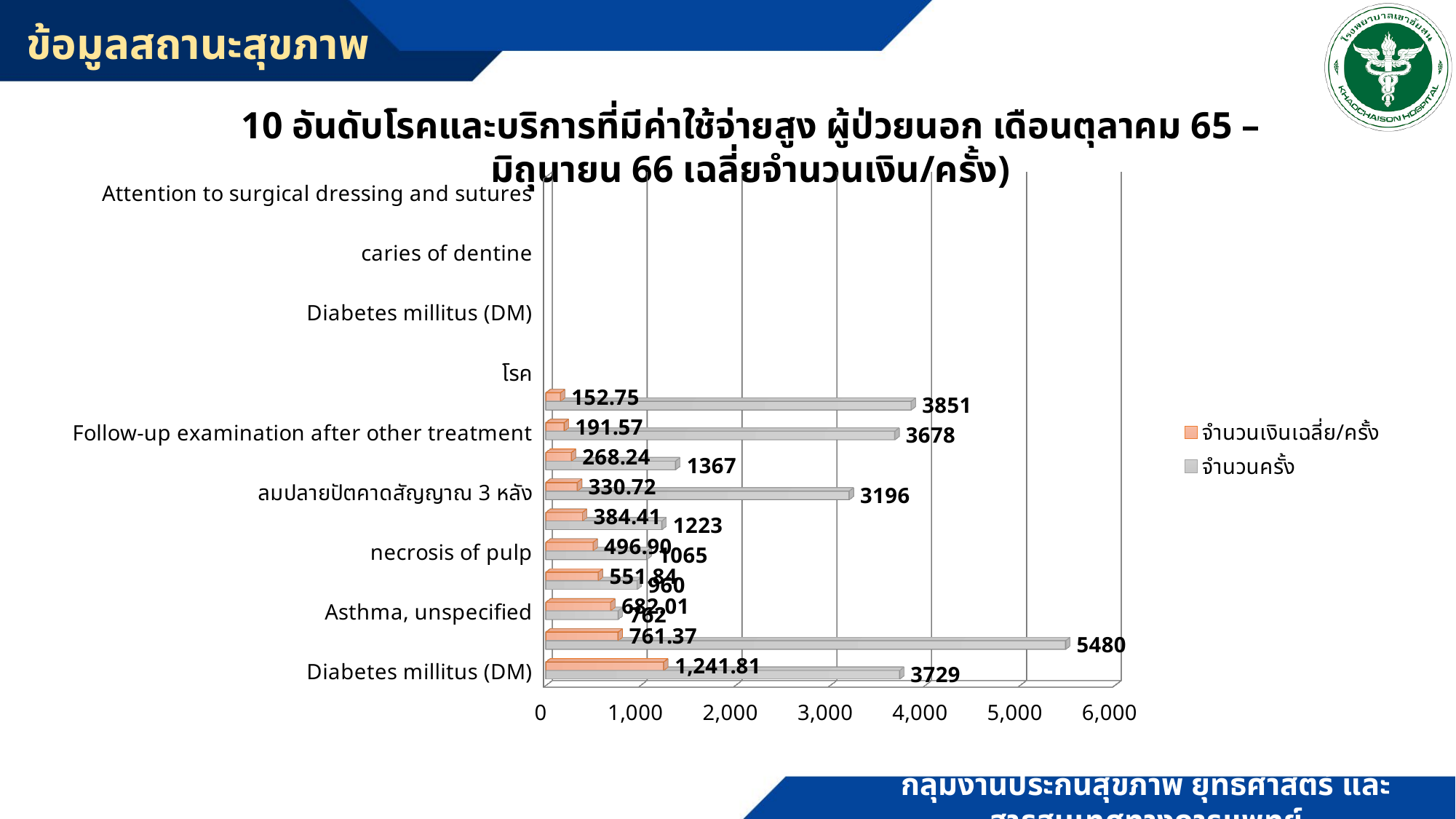
What is the highest จำนวนเงินเฉลี่ย/ครั้ง value shown in the chart? 1,241.81 Is the highest จำนวนครั้ง value greater or less than 5,000? greater What is the difference between the highest จำนวนครั้ง value (5480) and the จำนวนครั้ง value of the bottom bar (3729)? 1751 What is the lowest จำนวนเงินเฉลี่ย/ครั้ง value shown in the chart? 152.75 What type of chart is shown on the slide? bar chart What is the lowest จำนวนครั้ง value shown in the chart? 762 What is the จำนวนเงินเฉลี่ย/ครั้ง value for Asthma, unspecified? 682.01 How many series does the legend list? 2 What is the highest จำนวนครั้ง value shown in the chart? 5480 Which colour represents the จำนวนครั้ง series in the legend? gray What is the จำนวนครั้ง value for necrosis of pulp? 1065 How many pairs of bars (categories) are plotted in the chart? 10